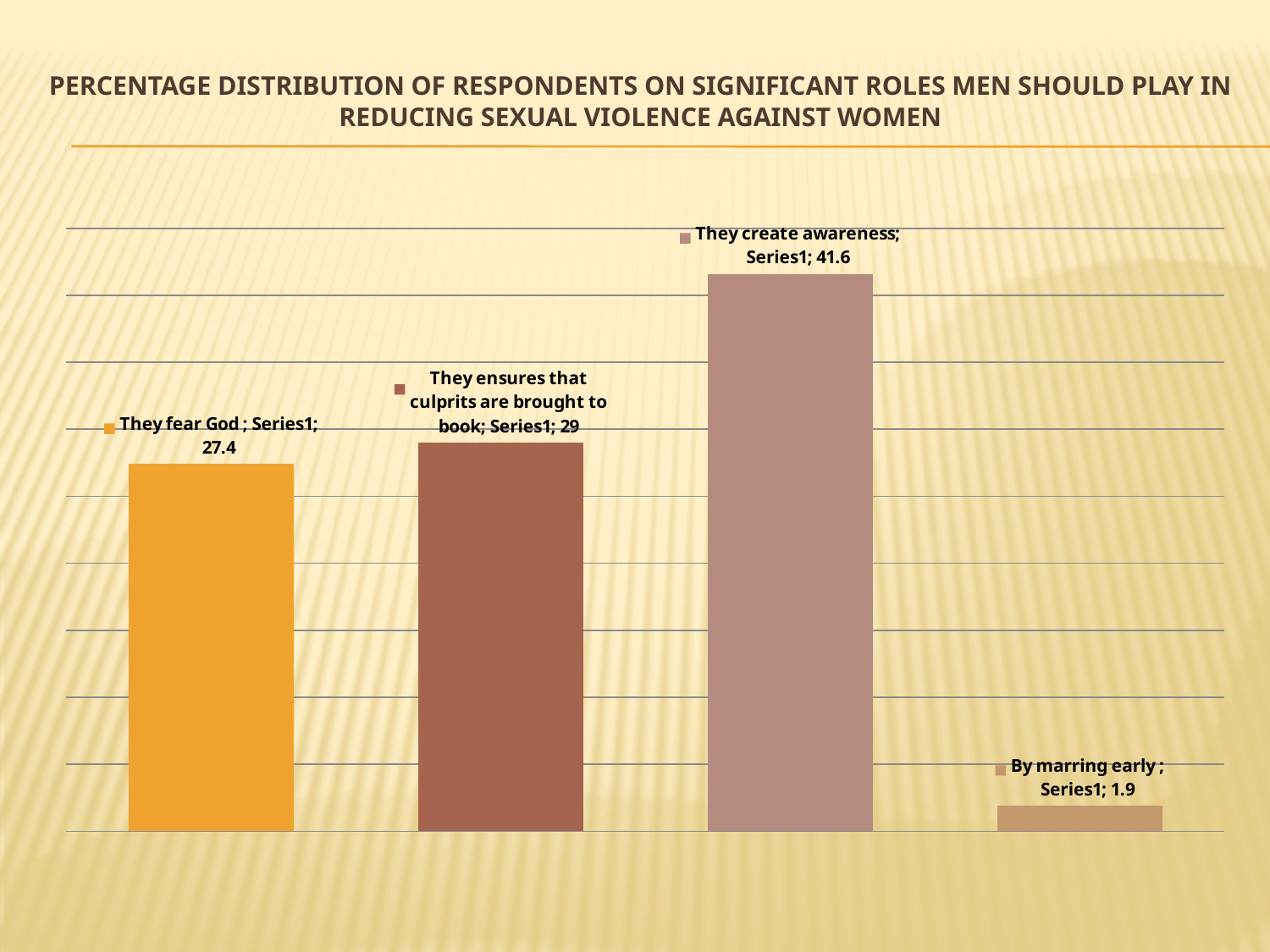
How many categories are shown in the chart? 4 What is the difference between the values for 'They create awareness' and 'They fear God'? 14.2 What is the value for 'By marring early'? 1.9 Which category has the highest value? They create awareness What is the value for 'They create awareness'? 41.6 Which category has the lowest value? By marring early What is the value for 'They fear God'? 27.4 What kind of chart is shown on the slide? Bar chart What is the value for 'They ensures that culprits are brought to book'? 29 What is the title of the chart? Percentage distribution of respondents on significant roles men should play in reducing sexual violence against women What is the difference between the values for 'They ensures that culprits are brought to book' and 'By marring early'? 27.1 Which is larger: the value for 'They fear God' or the value for 'They ensures that culprits are brought to book'? They ensures that culprits are brought to book